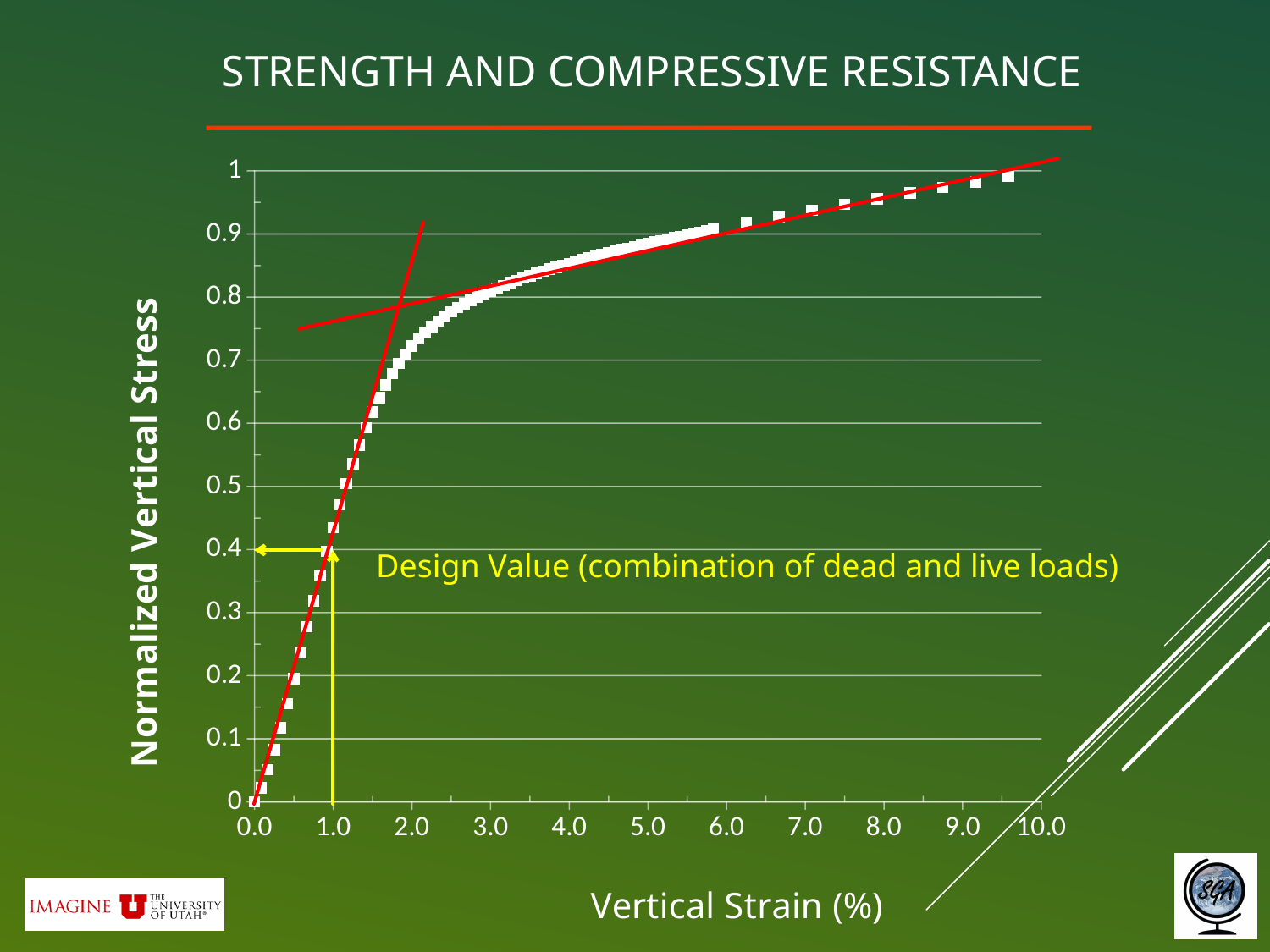
Is the normalized vertical stress at a vertical strain of 6.0% greater or less than 0.8? greater What is the label of the x axis? Vertical Strain (%) Is the normalized vertical stress at a vertical strain of 3.0% greater or less than 0.7? greater What is the label of the y axis? Normalized Vertical Stress What kind of chart is shown on the slide? scatter chart Is the normalized vertical stress at a vertical strain of 2.0% greater or less than 0.9? less What is the highest value shown on the x axis? 10.0 Do the plotted values rise or fall as vertical strain increases along the x axis? rise